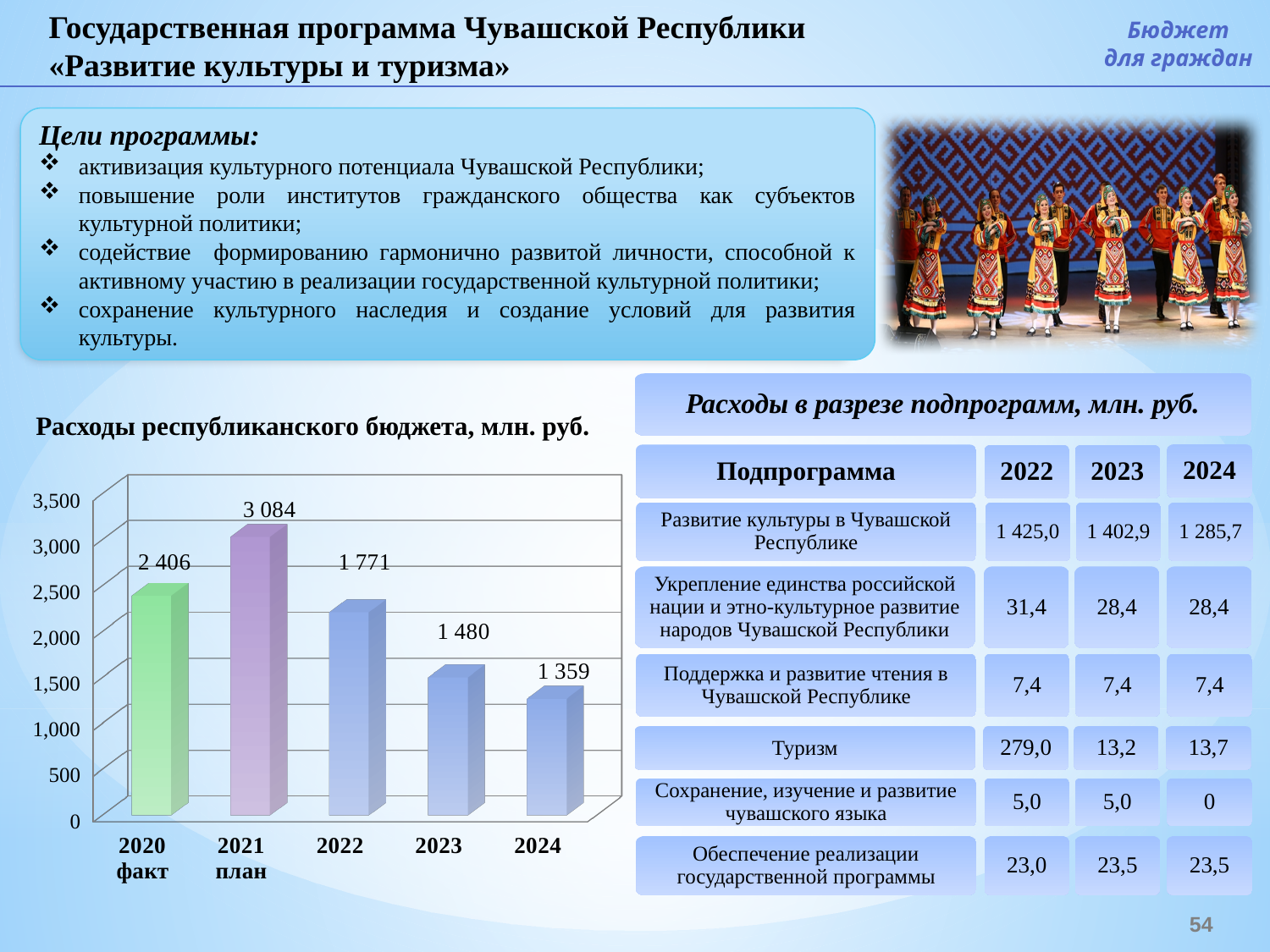
Which year has the highest value in the chart 'Расходы республиканского бюджета, млн. руб.'? 2021 план What is the value for 2024 in the chart 'Расходы республиканского бюджета, млн. руб.'? 1 359 Is the value for 2023 greater or less than 1,500 in the chart 'Расходы республиканского бюджета, млн. руб.'? less In the chart 'Расходы республиканского бюджета, млн. руб.', do the values rise or fall from 2021 план to 2024? fall Which year has the lowest value in the chart 'Расходы республиканского бюджета, млн. руб.'? 2024 What kind of chart is 'Расходы республиканского бюджета, млн. руб.'? bar chart Which is larger in the chart 'Расходы республиканского бюджета, млн. руб.': the value for 2022 or the value for 2023? 2022 What is the difference between the values for 2021 план and 2020 факт in the chart 'Расходы республиканского бюджета, млн. руб.'? 678 How many bars are shown in the chart 'Расходы республиканского бюджета, млн. руб.'? 5 What is the difference between the values for 2022 and 2023 in the chart 'Расходы республиканского бюджета, млн. руб.'? 291 What is the value for 2020 факт in the chart 'Расходы республиканского бюджета, млн. руб.'? 2 406 What is the value for 2021 план in the chart 'Расходы республиканского бюджета, млн. руб.'? 3 084